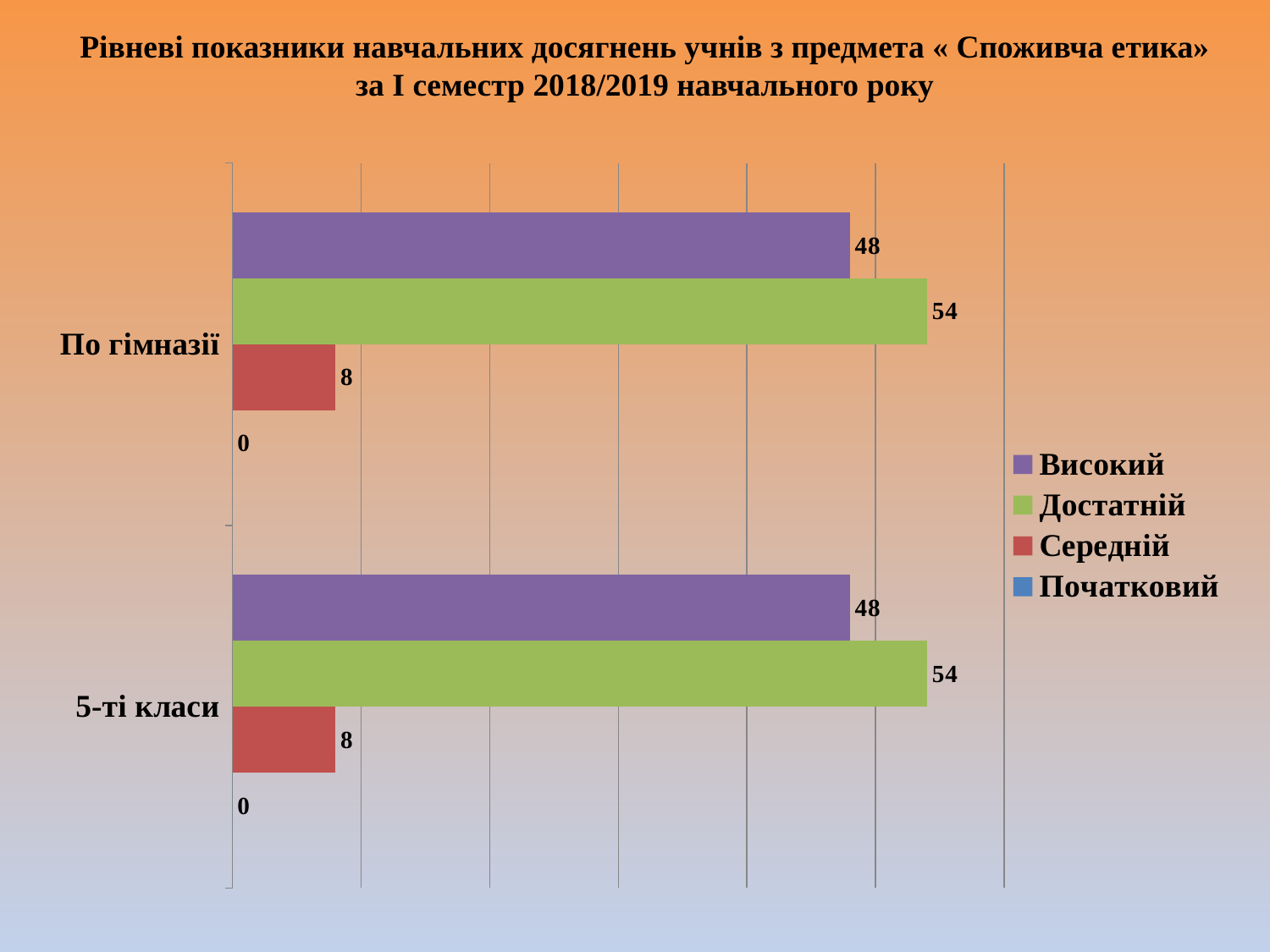
How many categories are shown on the chart? 2 What is the value of Достатній for По гімназії? 54 Which series has the highest value for 5-ті класи? Достатній What kind of chart is shown on the slide? bar chart What is the value of Середній for По гімназії? 8 Which legend entry is shown in green? Достатній What is the difference between Достатній and Високий for По гімназії? 6 Which series has the lowest value for По гімназії? Початковий What is the value of Початковий for 5-ті класи? 0 How many series does the legend list? 4 Which is larger for 5-ті класи, Високий or Середній? Високий What is the value of Високий for 5-ті класи? 48